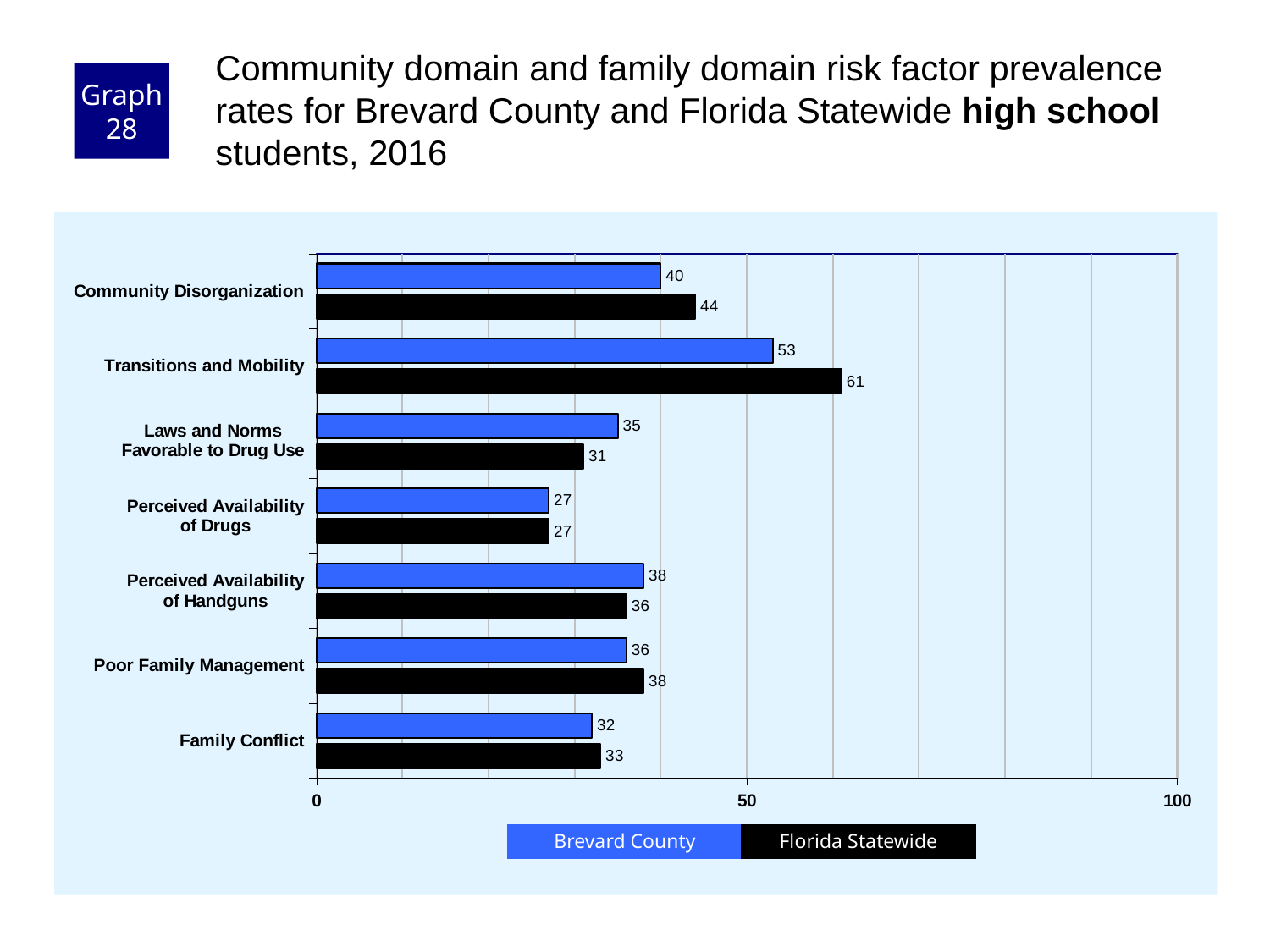
What is the Florida Statewide value for Community Disorganization? 44 What kind of chart is shown on the slide? bar chart Which risk factor has the lowest Brevard County value? Perceived Availability of Drugs How many risk factor categories are shown on the chart? 7 For Perceived Availability of Handguns, which is larger: the Brevard County value or the Florida Statewide value? Brevard County What is the Brevard County value for Transitions and Mobility? 53 Which colour represents Florida Statewide in the chart? black How many series does the legend list? 2 What is the difference between the Florida Statewide and Brevard County values for Transitions and Mobility? 8 Is the Florida Statewide value for Transitions and Mobility greater or less than 50? greater What is the Florida Statewide value for Laws and Norms Favorable to Drug Use? 31 Which risk factor has the highest Florida Statewide value? Transitions and Mobility